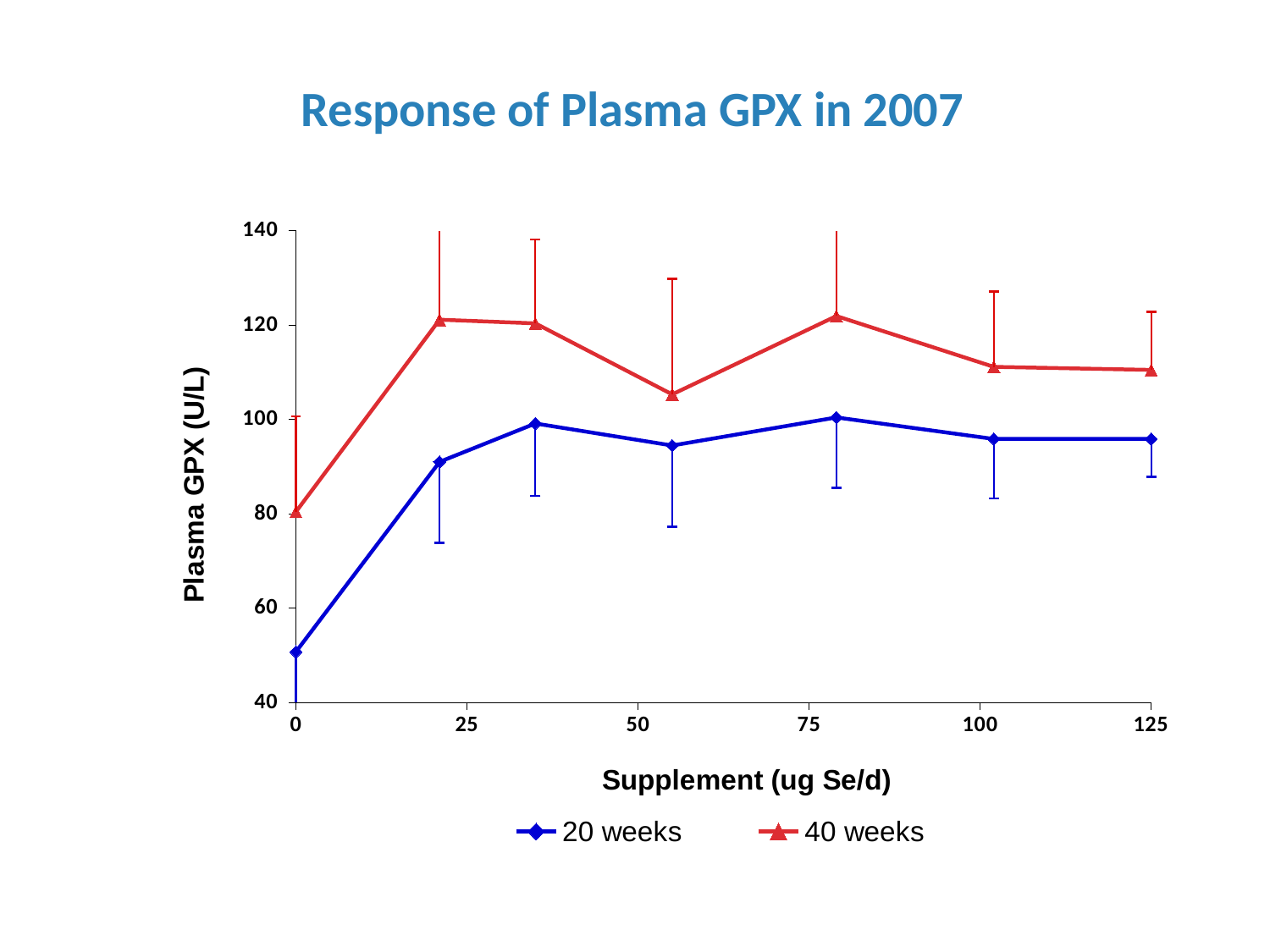
Is the value for the 20 weeks series at a supplement of 0 ug Se/d greater or less than 60? less What kind of chart is shown on the slide? line chart What are the two series named in the legend? 20 weeks and 40 weeks How many data points are plotted for the 20 weeks series? 7 Is the value for the 40 weeks series at a supplement of 125 ug Se/d greater or less than 100? greater Is the value for the 40 weeks series at a supplement of about 21 ug Se/d greater or less than 100? greater What is the title of the chart? Response of Plasma GPX in 2007 At which supplement level is the 20 weeks series at its lowest value? 0 Does the 20 weeks series rise or fall between a supplement of 0 and about 35 ug Se/d? rise How many series does the legend list? 2 At a supplement of 125 ug Se/d, which series has the higher Plasma GPX value, 20 weeks or 40 weeks? 40 weeks